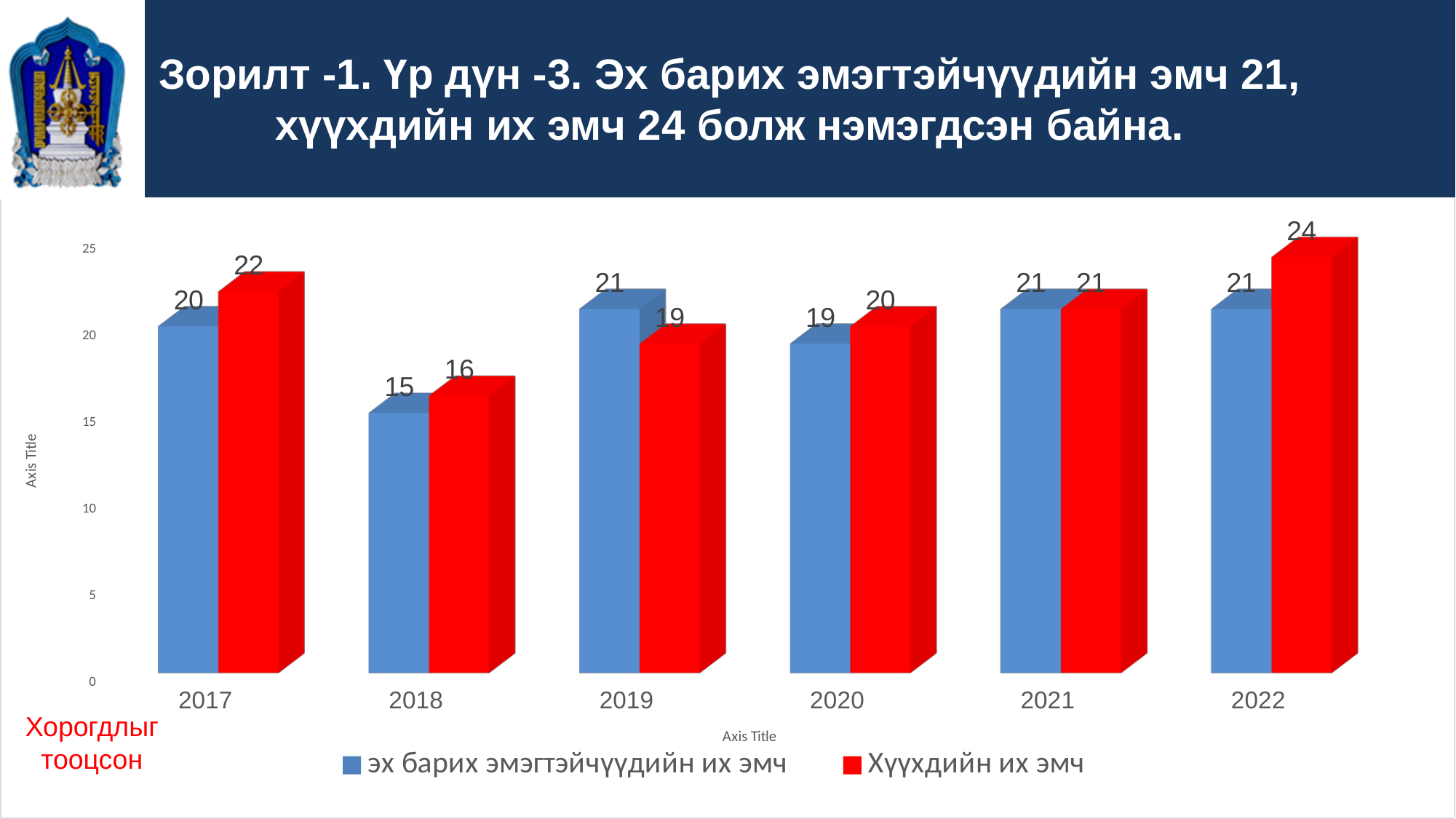
What is the value for 'Хүүхдийн их эмч' in 2022? 24 In which year is the value for 'Хүүхдийн их эмч' the highest? 2022 What is the value for 'Хүүхдийн их эмч' in 2019? 19 What is the difference between the 'Хүүхдийн их эмч' value and the 'эх барих эмэгтэйчүүдийн их эмч' value in 2022? 3 Which series has the larger value in 2019, 'эх барих эмэгтэйчүүдийн их эмч' or 'Хүүхдийн их эмч'? эх барих эмэгтэйчүүдийн их эмч Does the value for 'Хүүхдийн их эмч' rise or fall from 2020 to 2022? rise How many series does the legend list? 2 In which year is the value for 'Хүүхдийн их эмч' the lowest? 2018 What kind of chart is shown on the slide? bar chart What is the value for 'эх барих эмэгтэйчүүдийн их эмч' in 2017? 20 What colour are the bars for 'Хүүхдийн их эмч'? red How many years are shown on the x axis? 6